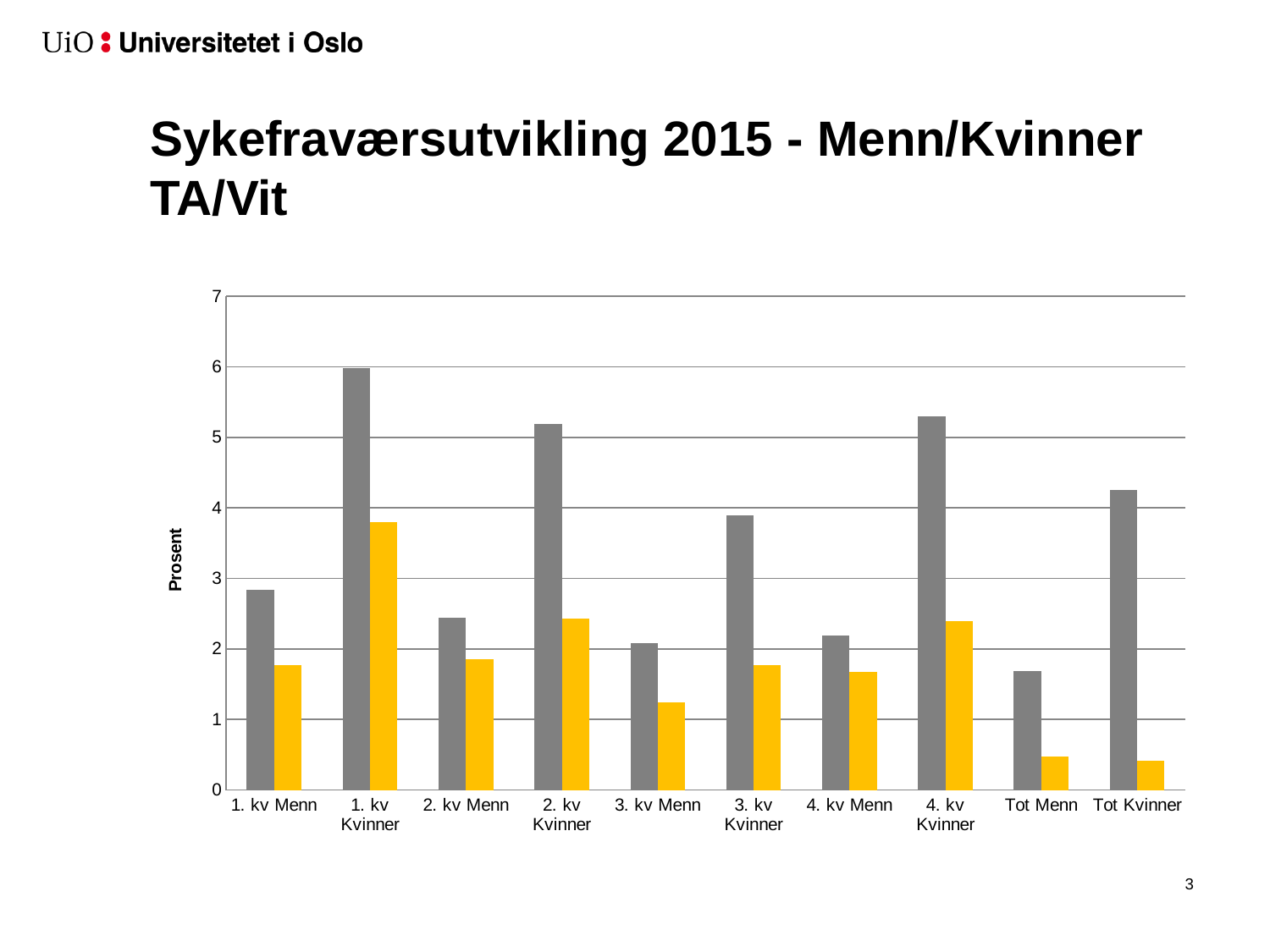
Which category has the tallest grey bar? 1. kv Kvinner Is the grey bar for Tot Kvinner greater or less than 4? greater How many categories are shown along the x axis of the chart? 10 Which category has the shortest grey bar? Tot Menn Which is taller for 3. kv Kvinner, the grey bar or the yellow bar? the grey bar Which category has the tallest yellow bar? 1. kv Kvinner Is the yellow bar for Tot Menn greater or less than 1? less Is the grey bar for 1. kv Kvinner greater or less than 5? greater What is the title of the slide containing the chart? Sykefraværsutvikling 2015 - Menn/Kvinner TA/Vit What kind of chart is shown on the slide? bar chart Which category has the shortest yellow bar? Tot Kvinner What is the title of the chart's vertical axis? Prosent